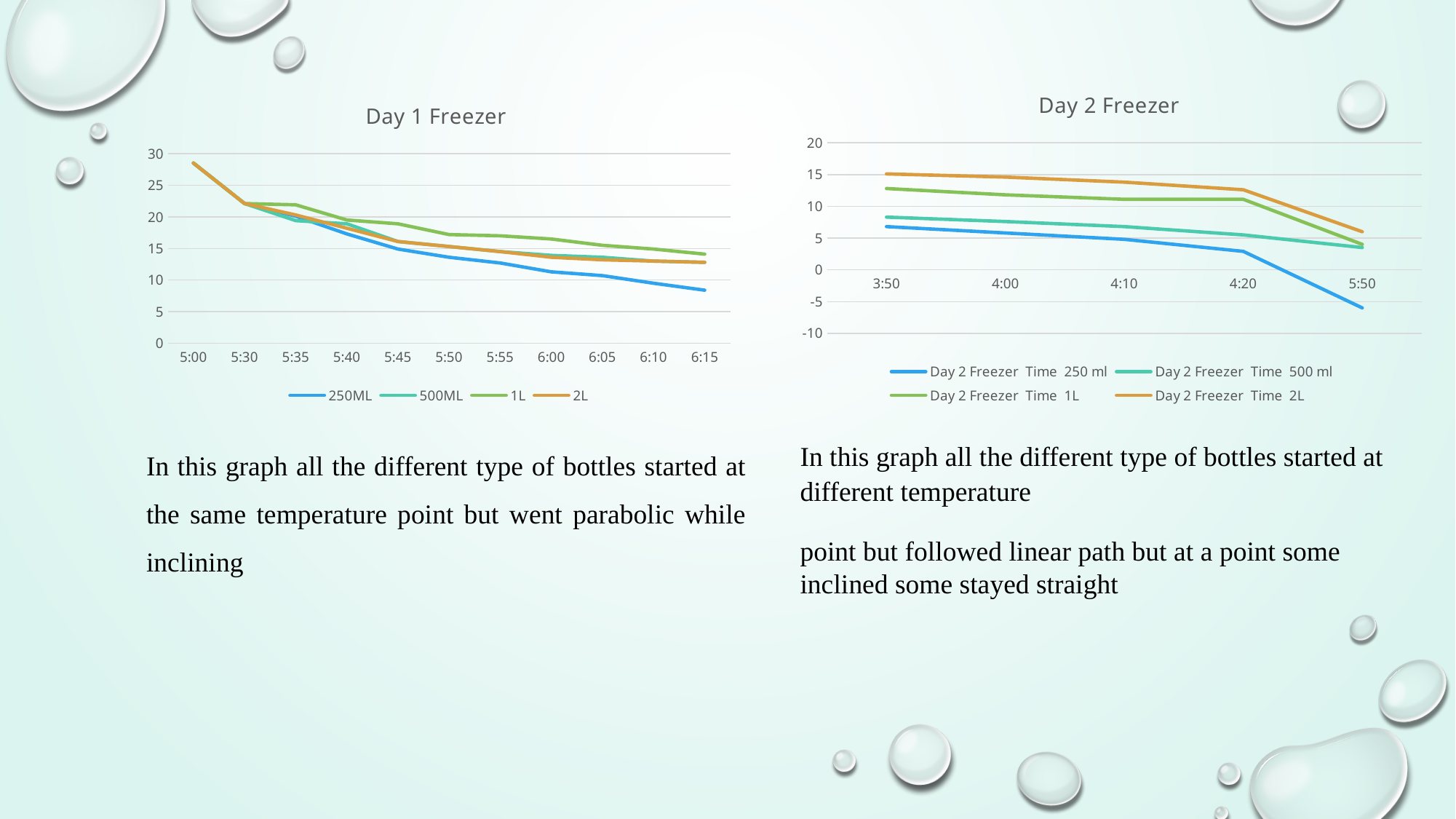
In the Day 2 Freezer chart, is the value for Day 2 Freezer Time 250 ml at 5:50 greater or less than 0? less What kind of chart is the Day 1 Freezer chart? line chart How many series does the legend of the Day 1 Freezer chart list? 4 In the Day 1 Freezer chart, do the values for 250ML rise or fall from 5:00 to 6:15? fall In the Day 1 Freezer chart, which series is lowest at 6:15? 250ML In the Day 2 Freezer chart, which series is highest at 3:50? Day 2 Freezer Time 2L In the Day 1 Freezer chart, is the value for 250ML at 6:15 greater or less than 10? less How many series does the legend of the Day 2 Freezer chart list? 4 In the Day 2 Freezer chart, which is larger at 3:50: Day 2 Freezer Time 250 ml or Day 2 Freezer Time 1L? Day 2 Freezer Time 1L How many time points are shown on the x axis of the Day 1 Freezer chart? 11 How many time points are shown on the x axis of the Day 2 Freezer chart? 5 In the Day 1 Freezer chart, is the value for 2L at 5:00 greater or less than 25? greater